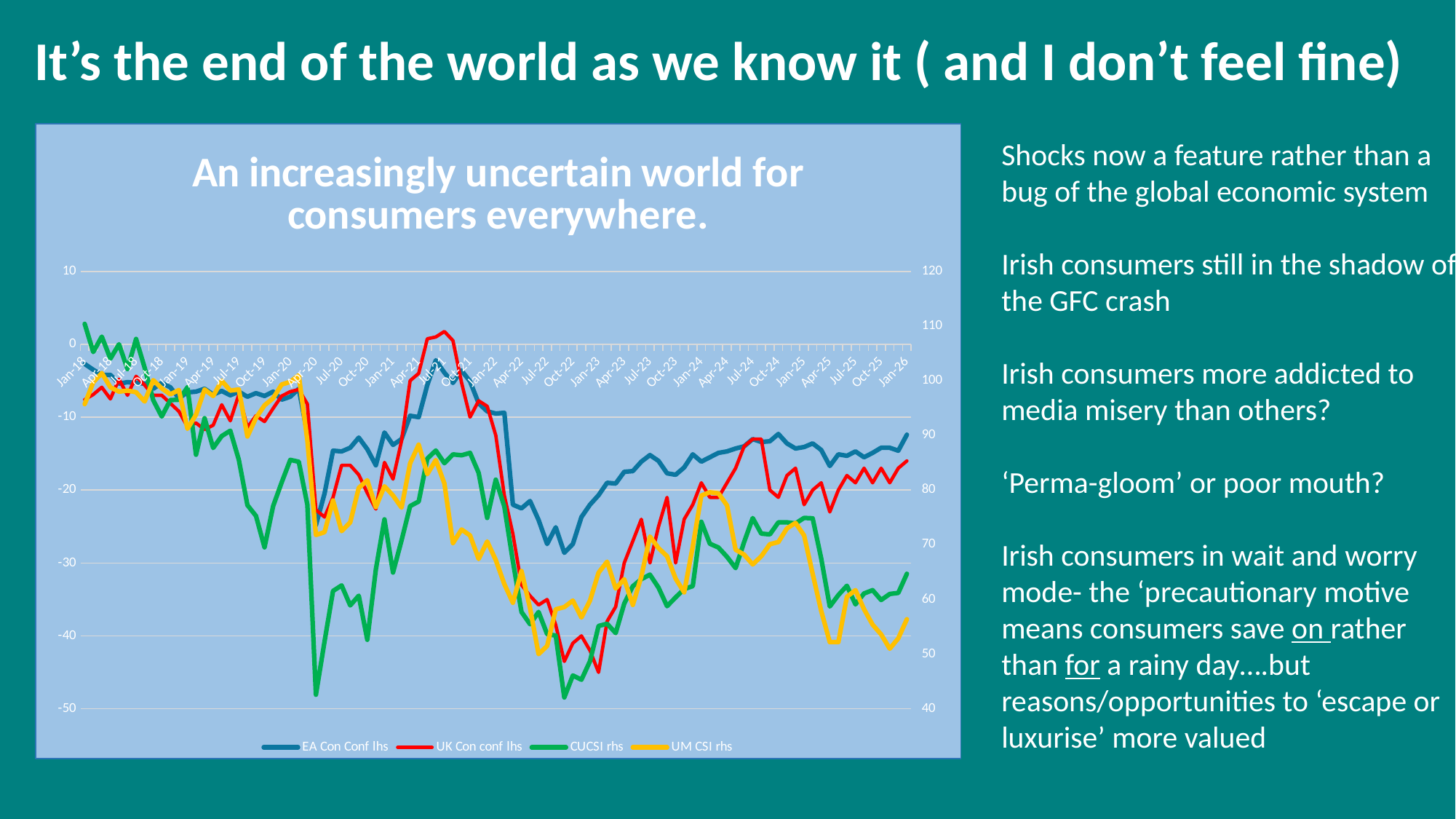
Is the lowest value of EA Con Conf lhs, reached around Oct-22, greater or less than -20? less Does the CUCSI rhs series rise or fall between Jan-20 and Apr-20? fall Is the value for EA Con Conf lhs at Jan-26 greater or less than -20? greater What kind of chart is shown on the slide? line chart Is the peak value of UK Con conf lhs around Jul-21 greater or less than 0? greater What is the title of the chart? An increasingly uncertain world for consumers everywhere. Which colour is used for the EA Con Conf lhs series? blue How many series does the chart legend list? 4 Does the EA Con Conf lhs series rise or fall between Oct-22 and Jan-24? rise